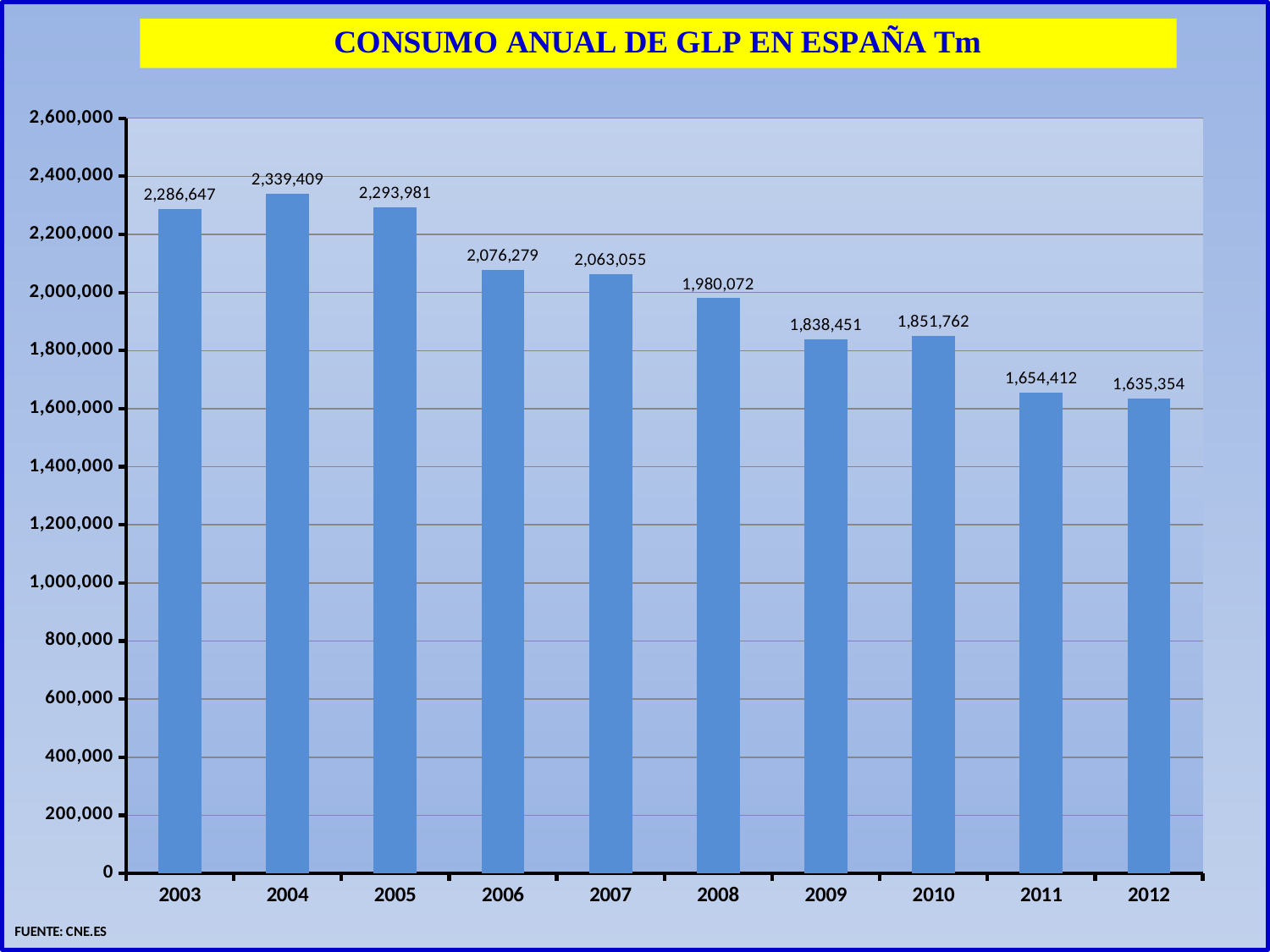
How many years are shown on the x axis? 10 Do the values generally rise or fall from 2003 to 2012? fall What is the value for 2003? 2,286,647 What kind of chart is this? bar chart What is the value for 2008? 1,980,072 What is the value for 2012? 1,635,354 Which year has the highest value? 2004 What is the difference between the values for 2004 and 2012? 704,055 Is the value for 2006 greater or less than 2,000,000? greater What is the title of the chart? CONSUMO ANUAL DE GLP EN ESPAÑA Tm Which is larger, the value for 2009 or the value for 2010? 2010 Which year has the lowest value? 2012